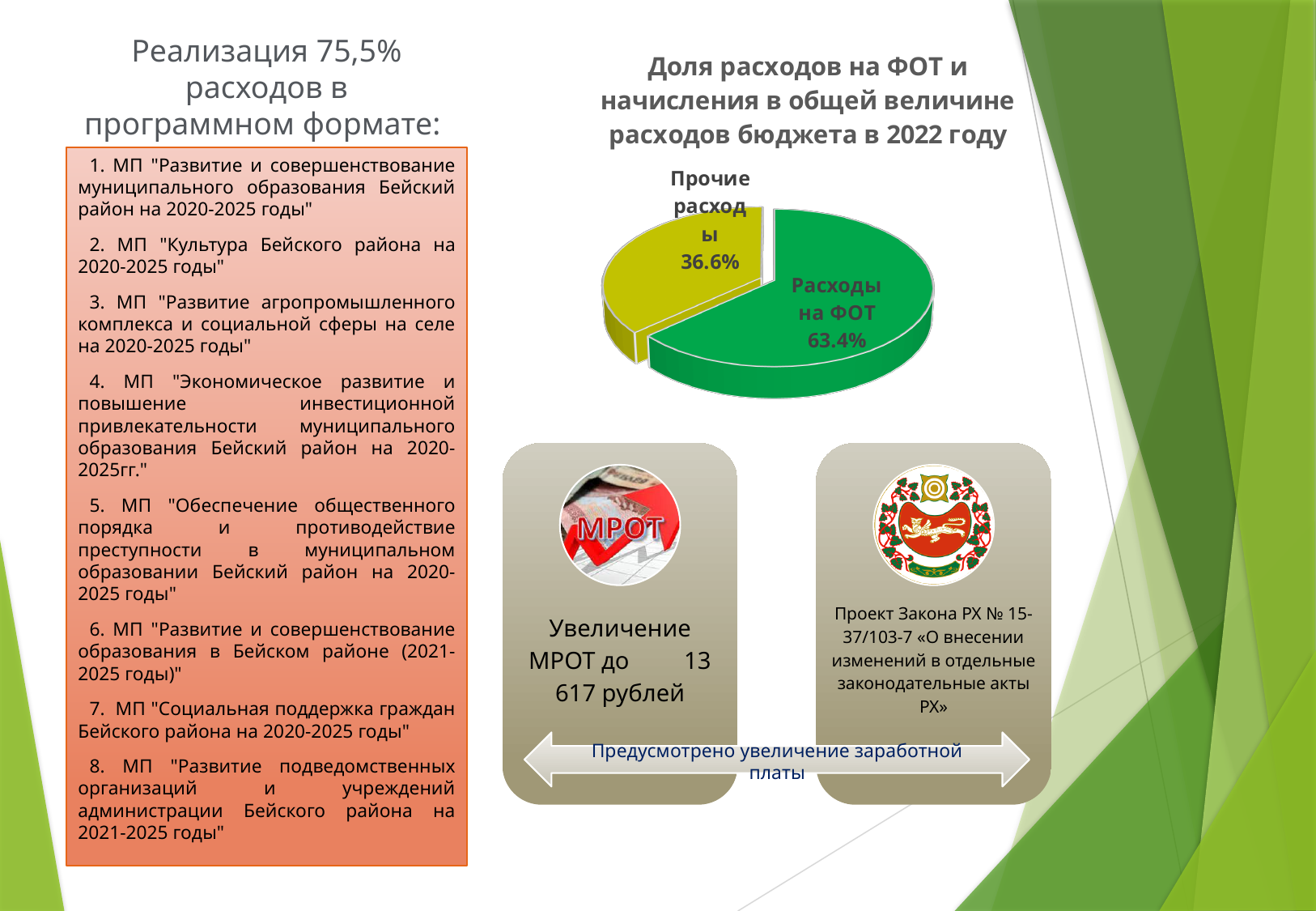
What share of the pie chart is labelled "Расходы на ФОТ"? 63.4% Which slice of the pie chart is the smallest? Прочие расходы Which is larger in the pie chart: "Расходы на ФОТ" or "Прочие расходы"? Расходы на ФОТ What share of the pie chart is labelled "Прочие расходы"? 36.6% What is the total of the two slices shown in the pie chart? 100% How many slices does the pie chart have? 2 What type of chart is shown on the slide? pie chart Is the share for "Расходы на ФОТ" greater or less than 50%? greater What is the difference in percentage points between the "Расходы на ФОТ" slice and the "Прочие расходы" slice? 26.8 What colour is the "Расходы на ФОТ" slice of the pie chart? green What is the title of the pie chart? Доля расходов на ФОТ и начисления в общей величине расходов бюджета в 2022 году Which slice of the pie chart is the largest? Расходы на ФОТ